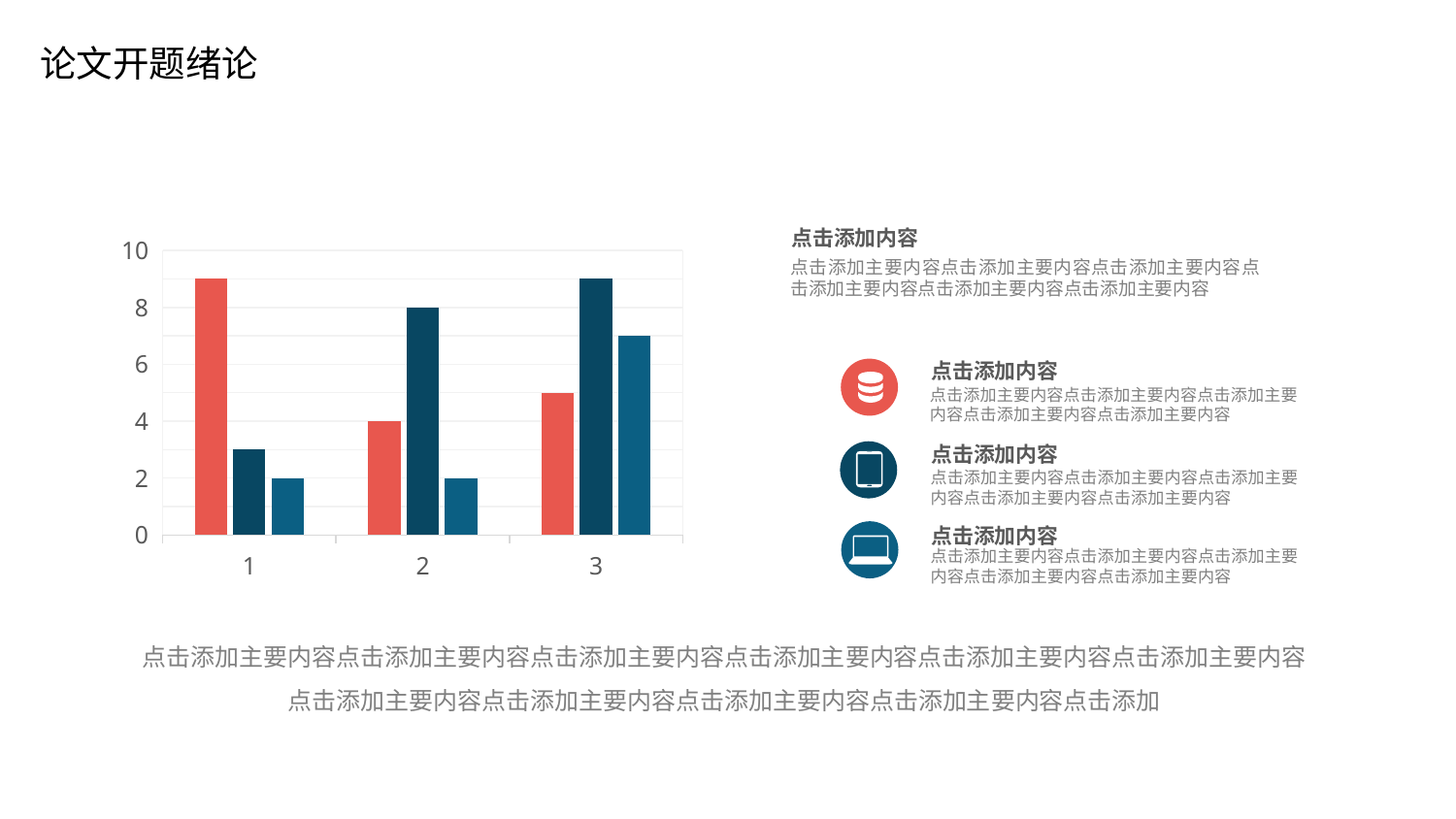
Is the value of the red bar for category 1 greater or less than 8? greater For category 2, which is larger: the red bar or the dark blue bar? the dark blue bar What is the value of the light blue bar for category 1? 2 What kind of chart is shown on the slide? bar chart Which category has the tallest red bar? 1 Is the value of the dark blue bar for category 1 greater or less than 4? less What is the difference between the dark blue bar and the red bar for category 2? 4 What is the value of the red bar for category 2? 4 Is the value of the light blue bar for category 3 greater or less than 6? greater What is the value of the dark blue bar for category 2? 8 How many bars are plotted for each category in the chart? 3 How many categories are shown on the x axis of the chart? 3